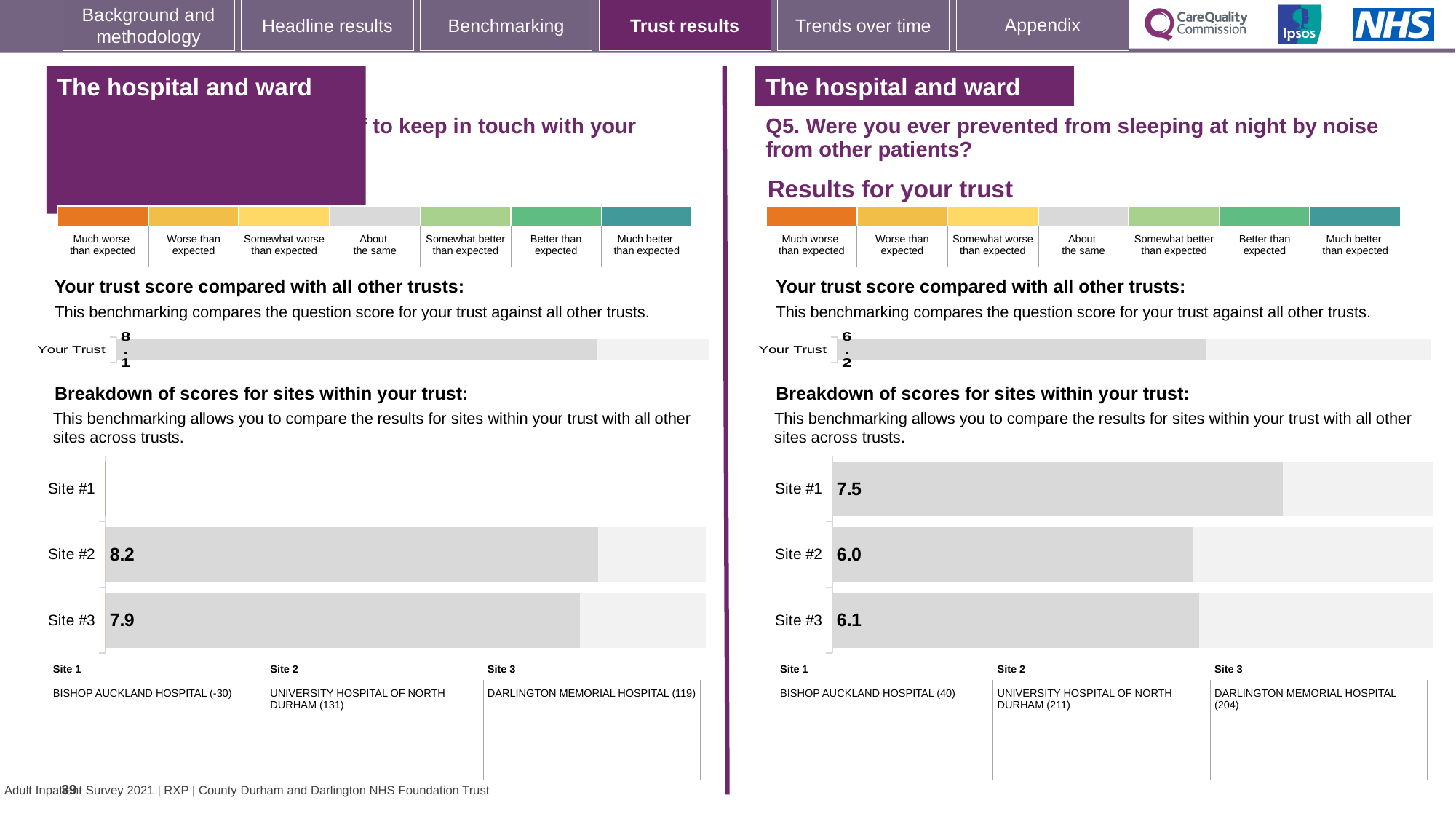
On the right-hand chart (Q5, prevented from sleeping at night by noise from other patients), what is the score for Site #1? 7.5 On the right-hand chart (Q5), what is the 'Your Trust' score compared with all other trusts? 6.2 On the left-hand chart, what is the 'Your Trust' score compared with all other trusts? 8.1 What kind of chart is used to show the breakdown of scores for sites within your trust on the right-hand side? Bar chart On the right-hand chart (Q5), what is the score for Site #3? 6.1 On the right-hand chart (Q5), which site has the highest score? Site #1 On the right-hand chart (Q5), what is the difference between the scores for Site #1 and Site #2? 1.5 On the left-hand chart, which is larger, the score for Site #2 or Site #3? Site #2 On the left-hand chart (breakdown of scores for sites within your trust), what is the score for Site #3? 7.9 On the right-hand chart (Q5), what is the score for Site #2? 6.0 On the left-hand chart, what is the difference between the scores for Site #2 and Site #3? 0.3 On the left-hand chart (breakdown of scores for sites within your trust), what is the score for Site #2? 8.2